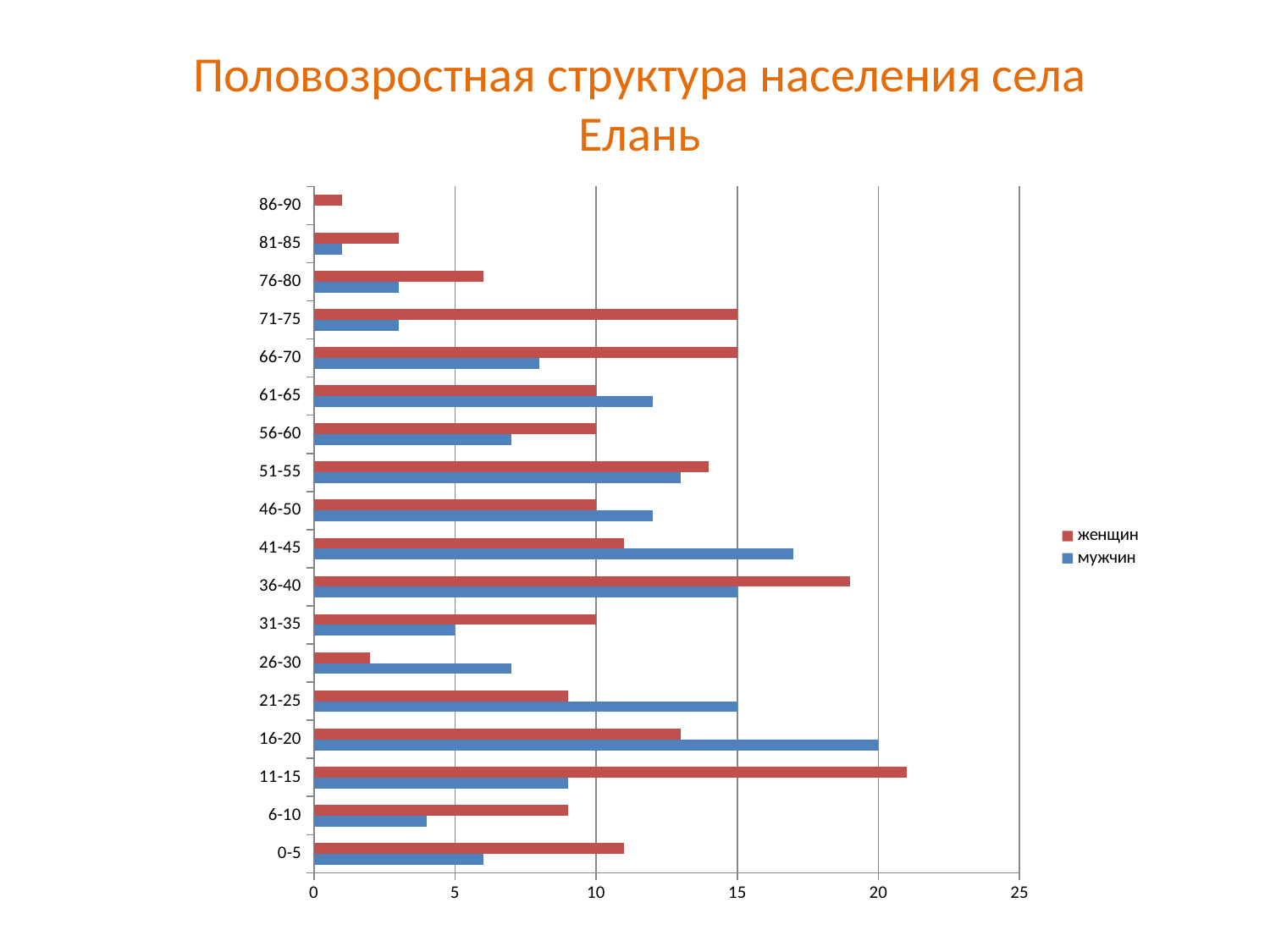
Which age group has the highest value for мужчин? 16-20 Which age group has the highest value for женщин? 11-15 How many series does the legend list? 2 Which age group has the lowest value for женщин? 86-90 What kind of chart is shown on the slide? bar chart What is the value for мужчин in the 16-20 age group? 20 Is the value for мужчин in the 41-45 age group greater or less than 15? greater How many age categories are shown on the chart? 18 What is the value for мужчин in the 31-35 age group? 5 In the 16-20 age group, which is larger: женщин or мужчин? мужчин What is the difference between the мужчин values for the 16-20 and 21-25 age groups? 5 What is the value for женщин in the 71-75 age group? 15